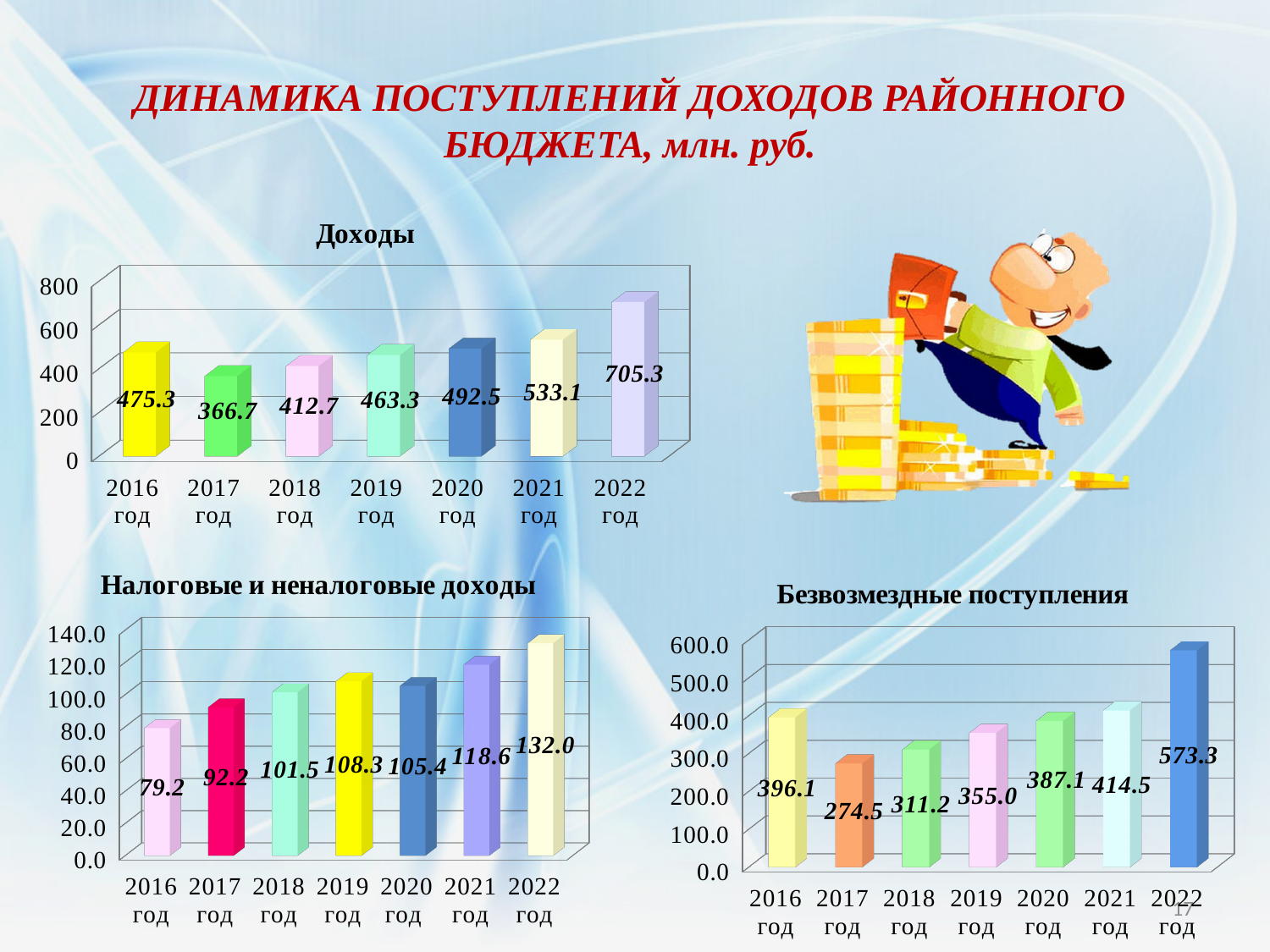
In the 'Налоговые и неналоговые доходы' chart, which year has the highest value? 2022 год In the 'Налоговые и неналоговые доходы' chart, which is larger, the value for 2019 год or 2020 год? 2019 год In the 'Налоговые и неналоговые доходы' chart, what is the value for 2019 год? 108.3 In the 'Безвозмездные поступления' chart, what is the difference between the values for 2022 год and 2016 год? 177.2 In the 'Безвозмездные поступления' chart, which year has the lowest value? 2017 год In the 'Доходы' chart, what is the value for 2022 год? 705.3 How many years are shown in the 'Доходы' chart? 7 In the 'Безвозмездные поступления' chart, what is the value for 2017 год? 274.5 What type of chart is the 'Безвозмездные поступления' chart? Bar chart In the 'Доходы' chart, what is the difference between the values for 2022 год and 2021 год? 172.2 In the 'Налоговые и неналоговые доходы' chart, is the value for 2016 год greater or less than 80.0? less In the 'Доходы' chart, which year has the lowest value? 2017 год